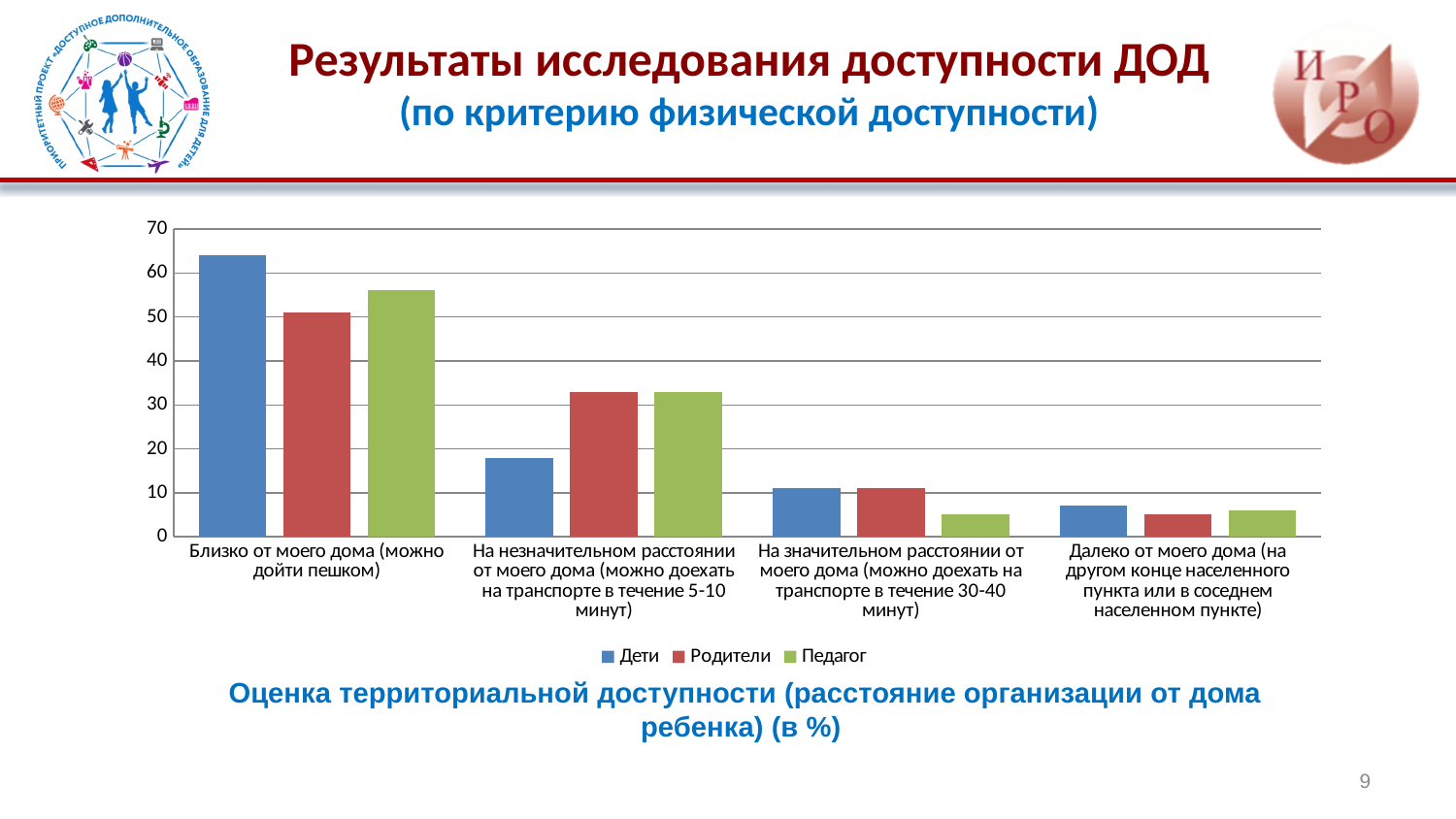
Is the value for Дети in the category "Близко от моего дома (можно дойти пешком)" greater or less than 60? greater Which series has the lowest value for the category "Близко от моего дома (можно дойти пешком)"? Родители How many categories are shown on the x axis? 4 Is the value for Педагог in the category "На незначительном расстоянии от моего дома" greater or less than 30? greater Do the values for Дети rise or fall from left to right across the categories? fall Is the value for Дети in the category "На незначительном расстоянии от моего дома" greater or less than 20? less What kind of chart is shown on the slide? bar chart How many series does the legend list? 3 Which is larger for the category "На значительном расстоянии от моего дома": the value for Родители or the value for Педагог? Родители What colour are the bars for the series Педагог? green Which category has the lowest value for Родители? Далеко от моего дома (на другом конце населенного пункта или в соседнем населенном пункте) Which series has the highest value for the category "Близко от моего дома (можно дойти пешком)"? Дети